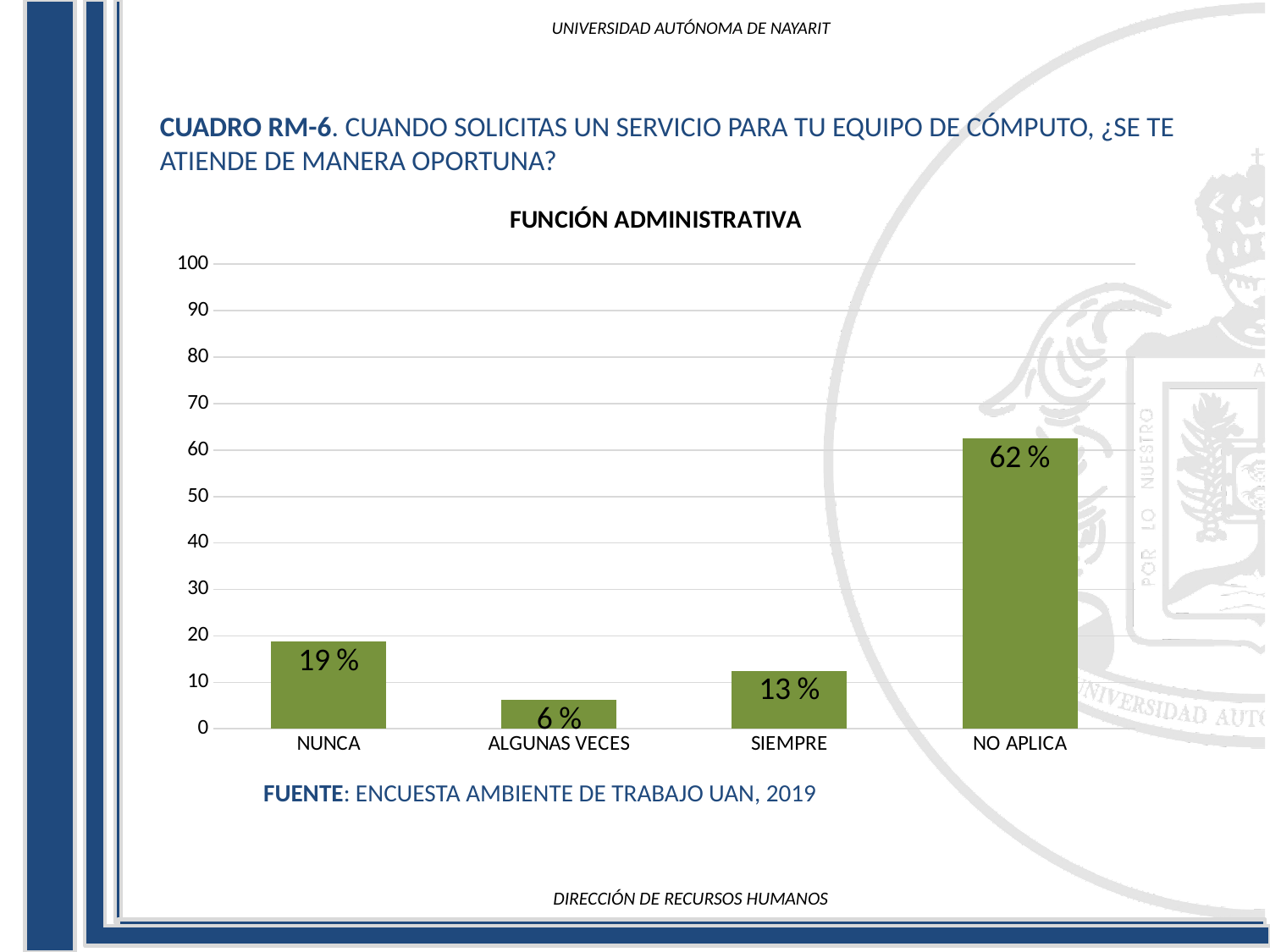
What is the difference between the values for NO APLICA and NUNCA? 43 % What is the value for ALGUNAS VECES? 6 % What is the value for SIEMPRE? 13 % How many categories are shown on the x axis? 4 Which category has the lowest value? ALGUNAS VECES What kind of chart is shown on the slide? Bar chart Is the value for NO APLICA greater or less than 50? greater What is the value for NO APLICA? 62 % What is the value for NUNCA? 19 % Which is larger, the value for NUNCA or the value for SIEMPRE? NUNCA What is the title of the chart? FUNCIÓN ADMINISTRATIVA Which category has the highest value? NO APLICA